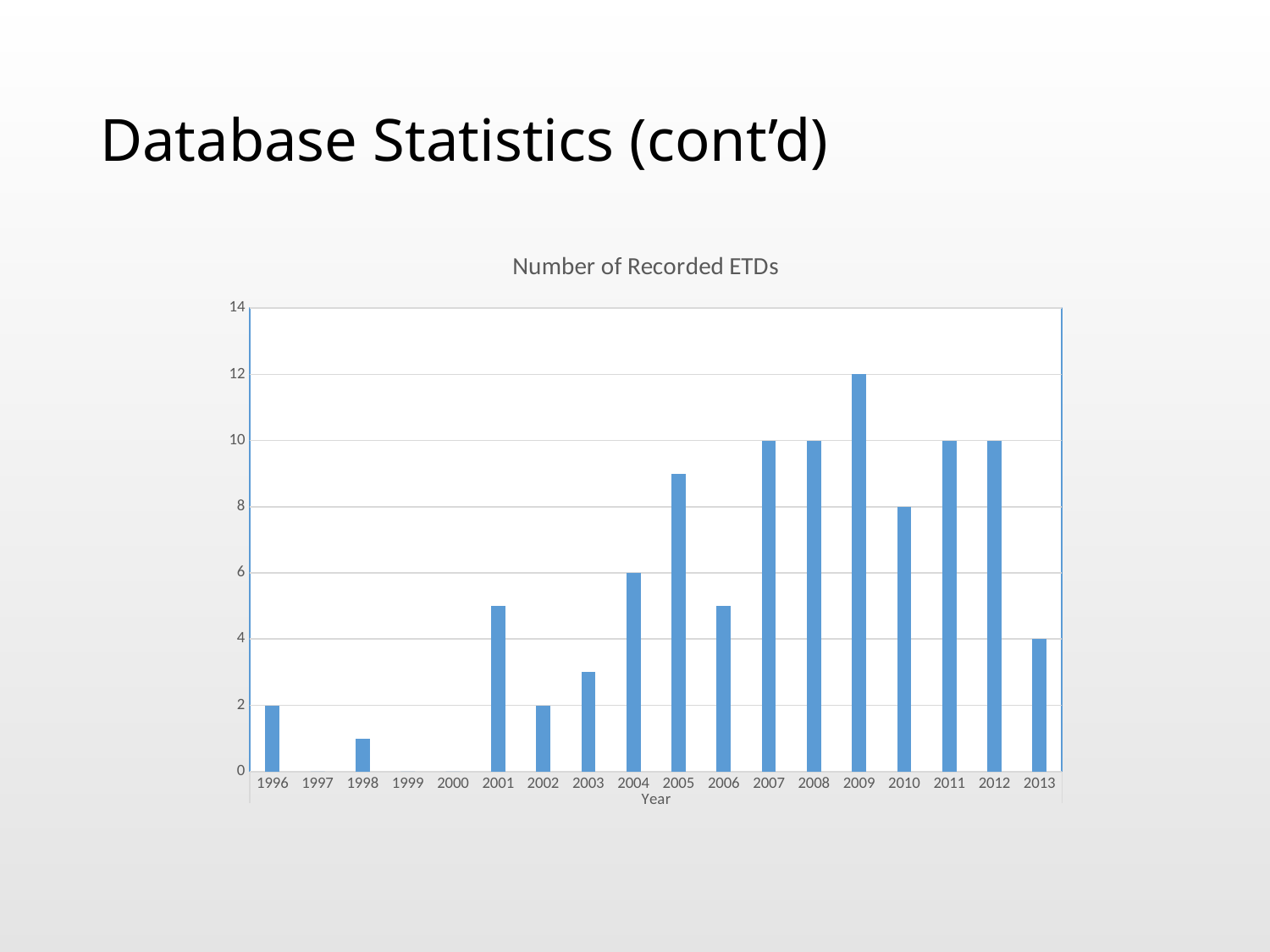
Which is larger, the value for 2006 or the value for 2007? 2007 What is the number of recorded ETDs for 2010? 8 How many years are shown on the x axis? 18 What is the number of recorded ETDs for 2013? 4 Is the value for 2003 greater or less than 4? less What is the title of the chart? Number of Recorded ETDs What is the number of recorded ETDs for 2009? 12 Which year has the highest number of recorded ETDs? 2009 What type of chart is shown on the slide? bar chart What is the number of recorded ETDs for 2004? 6 What is the difference between the values for 2009 and 2010? 4 Is the value for 2005 greater or less than 8? greater